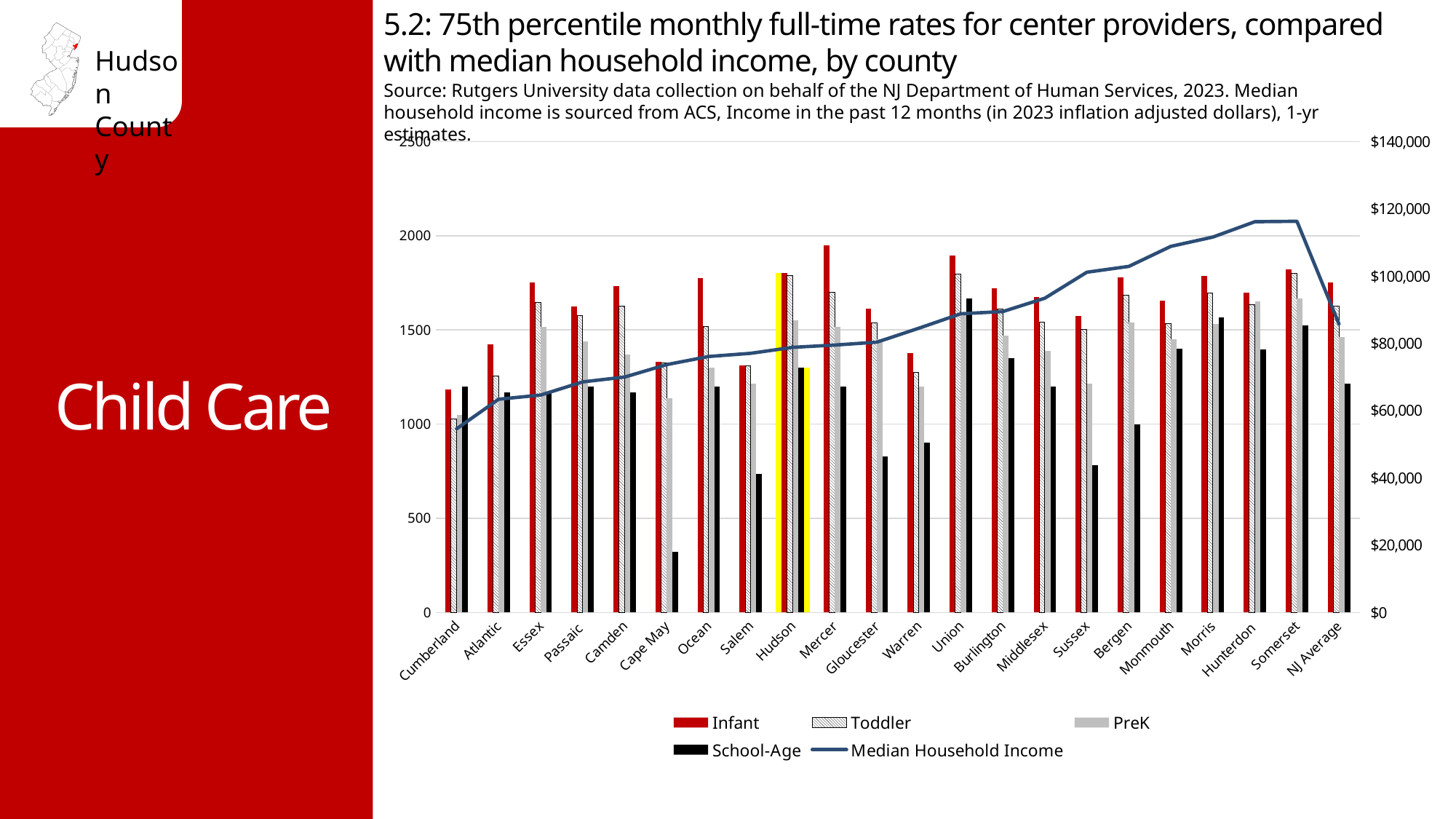
Is the Median Household Income for Somerset greater or less than $100,000? greater Which county's bars are highlighted in yellow? Hudson Which is larger, the Infant rate for Essex or the Infant rate for Atlantic? Essex Which county has the lowest School-Age rate? Cape May How many counties (including NJ Average) are shown on the x axis? 22 Is the School-Age value for Cape May greater or less than 500? less Is the Median Household Income for Cumberland greater or less than $60,000? less Which county has the highest Infant rate? Mercer Which county has the lowest Infant rate? Cumberland How many series does the legend list? 5 What kind of chart is this? Bar chart with a line